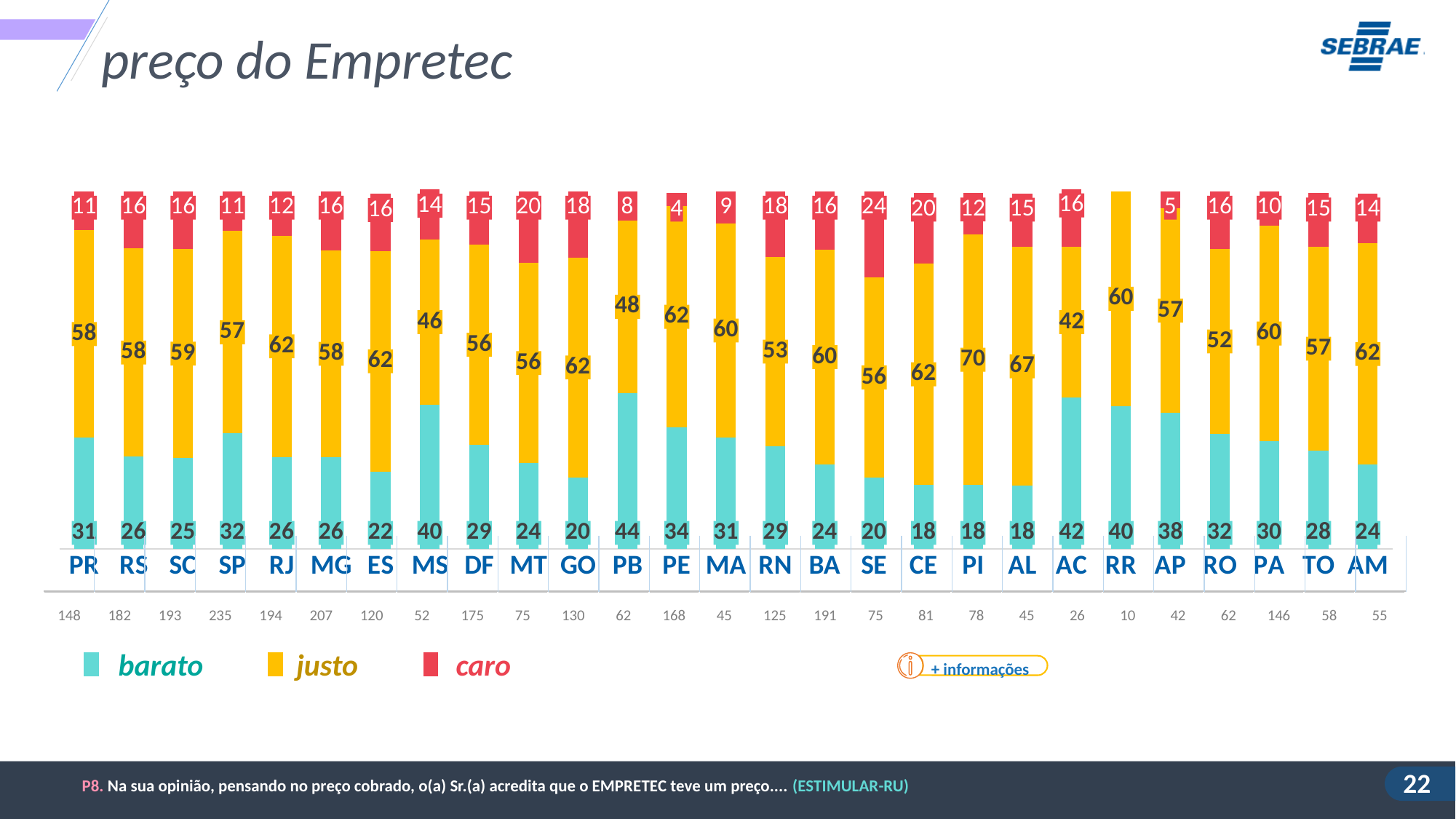
What is the 'barato' value for PB? 44 What is the difference between the 'barato' values for MS and ES? 18 How many states (categories) are shown on the x axis? 27 How many series does the legend list? 3 Which state has the lowest 'justo' value? AC What is the 'caro' value for SE? 24 Which is larger, the 'caro' value for MT or the 'caro' value for PE? MT Which state has the highest 'justo' value? PI Which state has the highest 'barato' value? PB What is the 'justo' value for PI? 70 What is the total of the stacked bar for AC (barato + justo + caro)? 100 What kind of chart is shown on the slide? bar chart